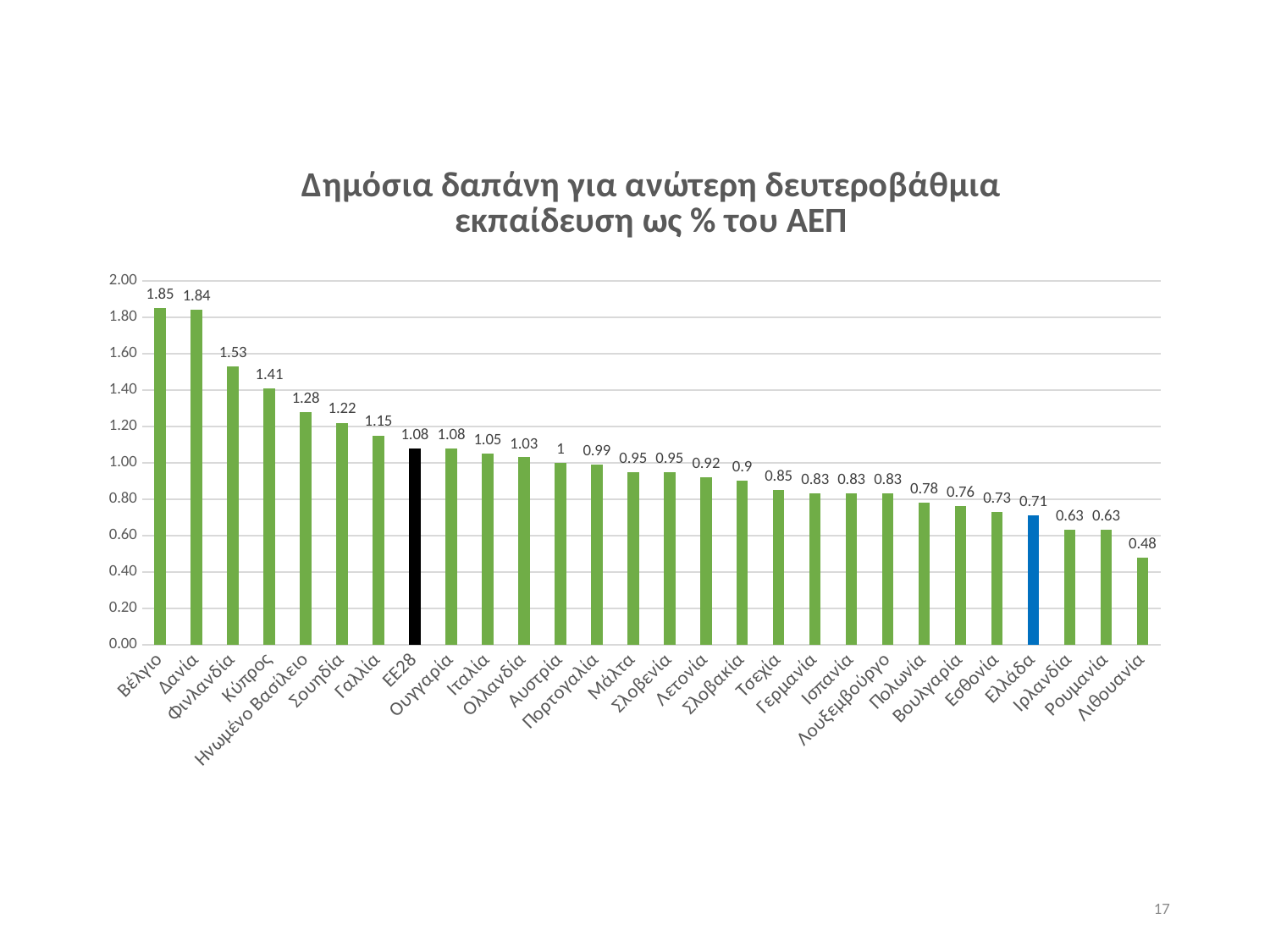
What is the value for Ηνωμένο Βασίλειο? 1.28 What colour is the bar for Ελλάδα? Blue Which country has the lowest value? Λιθουανία Which country has the highest value? Βέλγιο Is the value for Φινλανδία greater or less than 1.40? greater What is the value for ΕΕ28? 1.08 What is the value for Ελλάδα? 0.71 How many categories are shown on the x axis? 28 What kind of chart is this? Bar chart What is the difference between the values for Βέλγιο and Ελλάδα? 1.14 Do the values rise or fall from left to right along the x axis? Fall Which is larger, the value for Κύπρος or the value for Σουηδία? Κύπρος